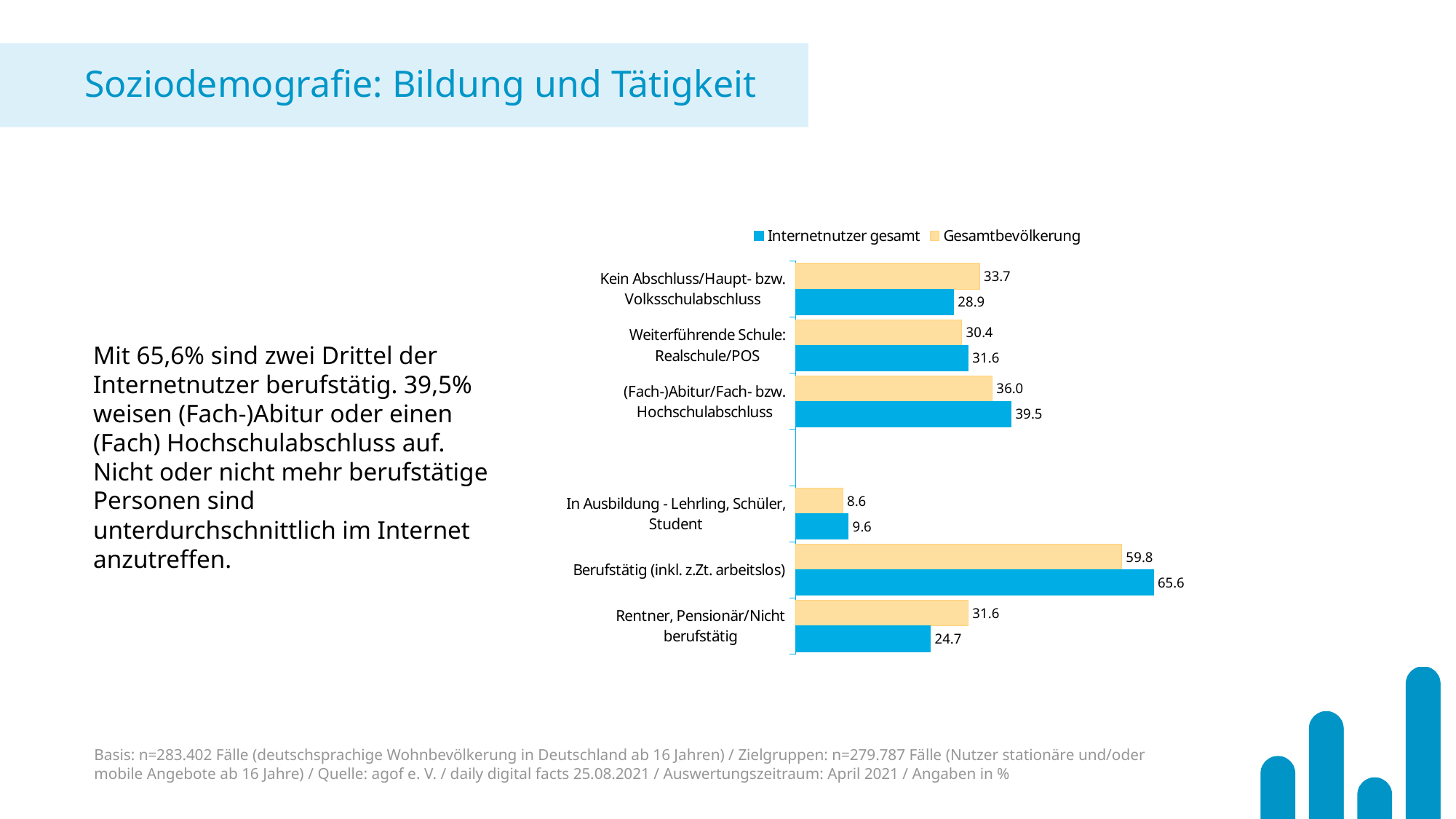
How many series does the legend list? 2 What is the difference between Internetnutzer gesamt and Gesamtbevölkerung in the Berufstätig (inkl. z.Zt. arbeitslos) category? 5.8 What is the value for Gesamtbevölkerung in the Kein Abschluss/Haupt- bzw. Volksschulabschluss category? 33.7 In the (Fach-)Abitur/Fach- bzw. Hochschulabschluss category, which series has the larger value, Internetnutzer gesamt or Gesamtbevölkerung? Internetnutzer gesamt Which category has the lowest value for Gesamtbevölkerung? In Ausbildung - Lehrling, Schüler, Student What is the value for Internetnutzer gesamt in the Berufstätig (inkl. z.Zt. arbeitslos) category? 65.6 What is the value for Gesamtbevölkerung in the In Ausbildung - Lehrling, Schüler, Student category? 8.6 What is the difference between Gesamtbevölkerung and Internetnutzer gesamt in the Rentner, Pensionär/Nicht berufstätig category? 6.9 What is the value for Internetnutzer gesamt in the Rentner, Pensionär/Nicht berufstätig category? 24.7 What kind of chart is shown on the slide? Bar chart Which category has the highest value for Internetnutzer gesamt? Berufstätig (inkl. z.Zt. arbeitslos) How many categories are shown in the chart? 6